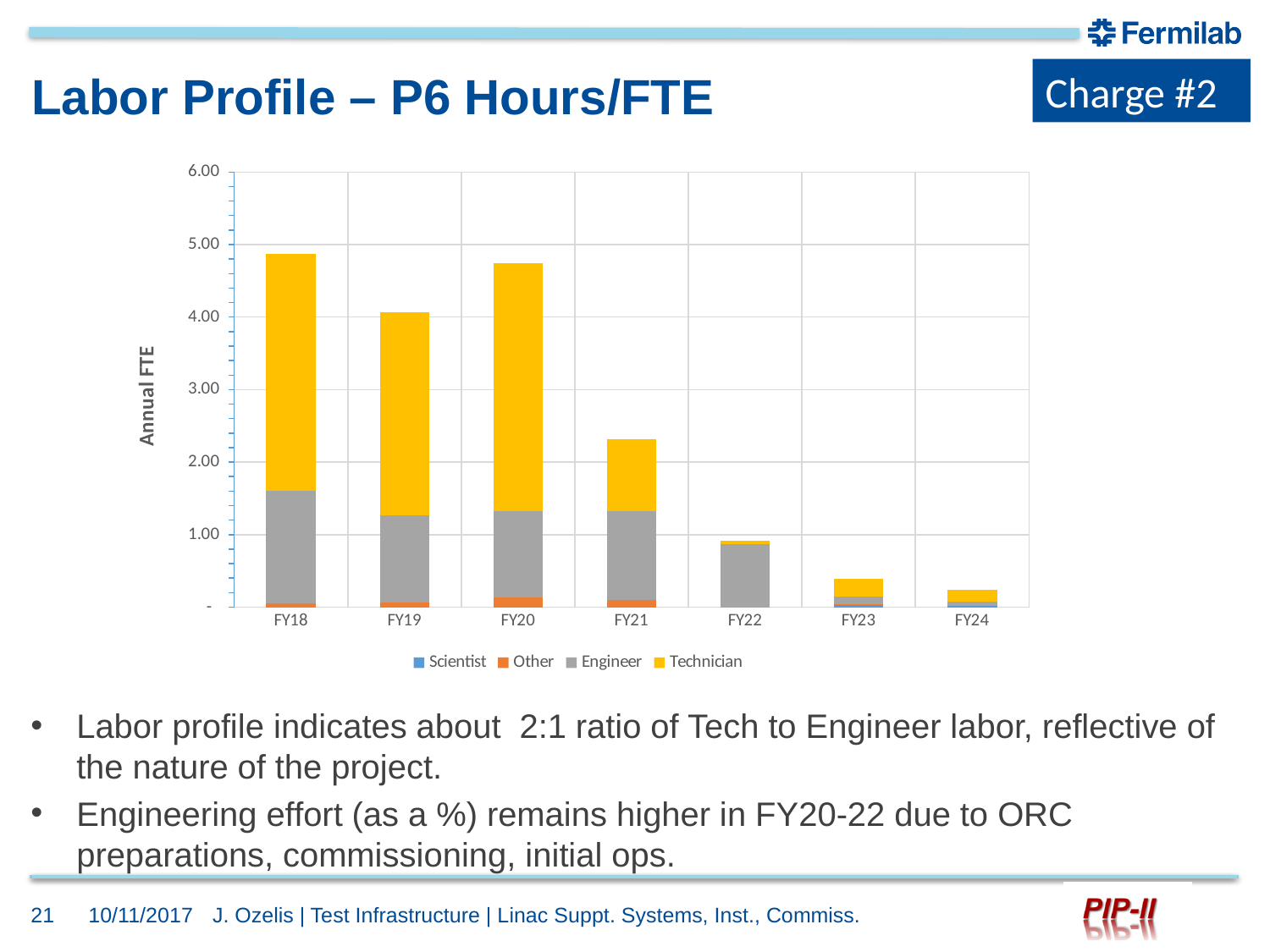
Is the total Annual FTE for FY22 greater or less than 1.00? less Do the total Annual FTE values rise or fall from FY21 to FY24? fall What kind of chart is shown on the slide? Stacked bar chart Is the total Annual FTE for FY18 greater or less than 4.00? greater Which fiscal year has the highest total Annual FTE? FY18 Which fiscal year has the lowest total Annual FTE? FY24 Which has the larger total Annual FTE, FY19 or FY21? FY19 How many fiscal years are shown on the x axis of the chart? 7 How many series does the chart legend list? 4 Is the total Annual FTE for FY21 greater or less than 2.00? greater What is the title of the vertical axis of the chart? Annual FTE Which series is shown in yellow in the chart? Technician